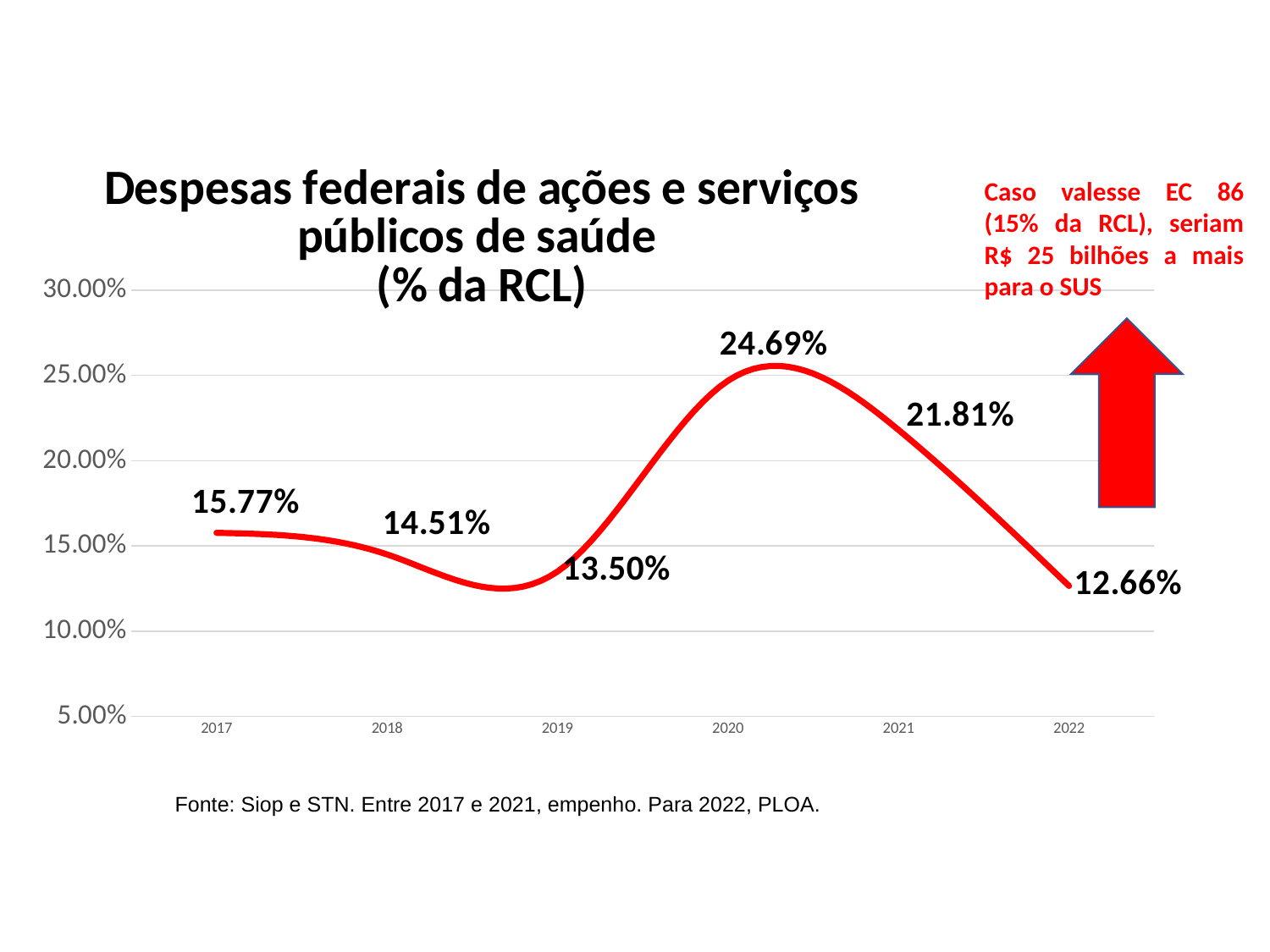
Does the value rise or fall from 2020 to 2022? fall Which is larger, the value for 2018 or the value for 2021? 2021 What is the difference between the values for 2020 and 2021? 2.88% What is the value for 2017? 15.77% Which year has the highest value? 2020 Which year has the lowest value? 2022 What kind of chart is shown? line chart What is the value for 2019? 13.50% What is the value for 2022? 12.66% What is the value for 2020? 24.69% How many years are plotted on the x axis? 6 Is the value for 2021 greater or less than 20.00%? greater